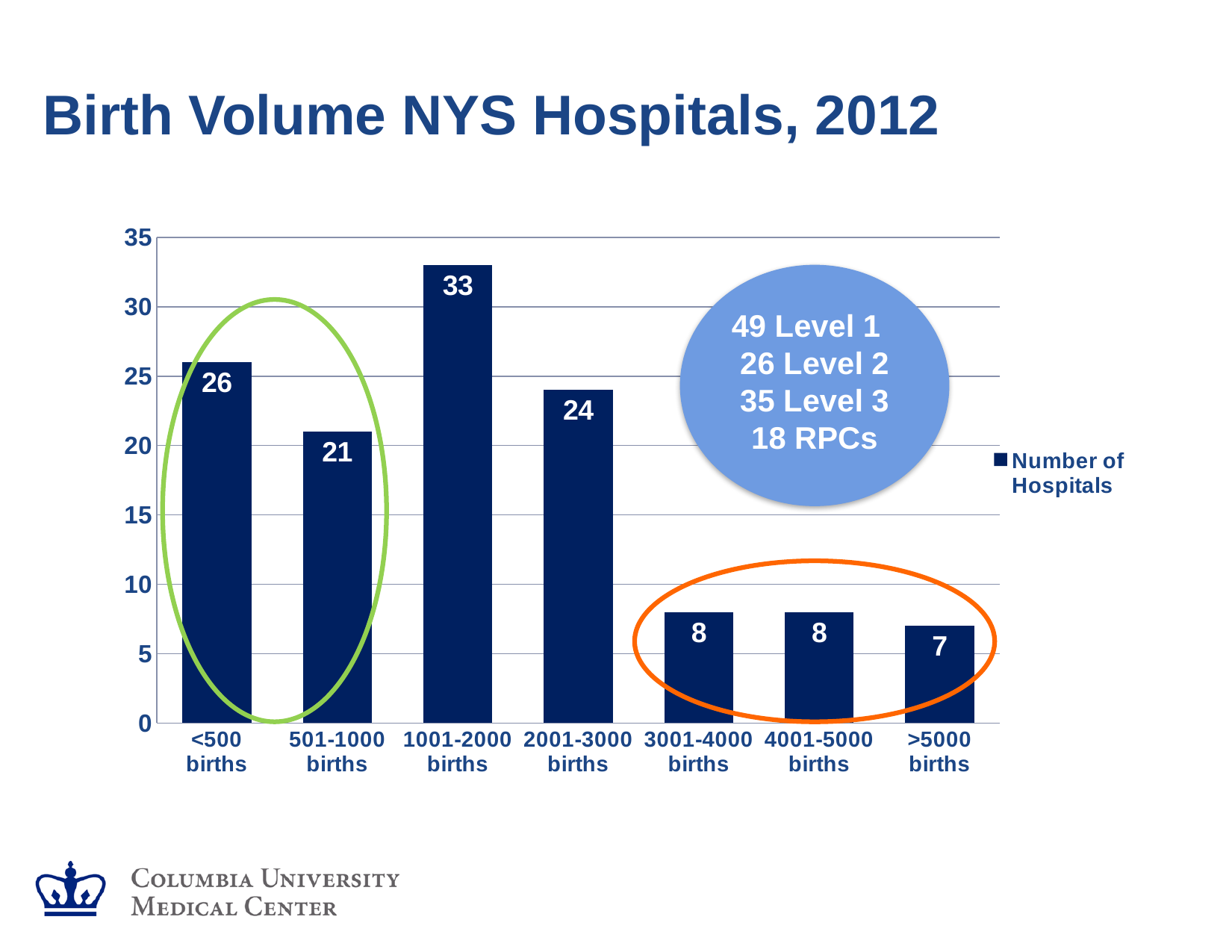
What kind of chart is shown on the slide? Bar chart What is the title of the chart on the slide? Birth Volume NYS Hospitals, 2012 Which birth volume category has the highest number of hospitals? 1001-2000 births What is the value for the >5000 births category? 7 What is the difference in number of hospitals between the 1001-2000 births and 2001-3000 births categories? 9 Which has more hospitals: the <500 births category or the 501-1000 births category? <500 births How many birth volume categories are shown on the x axis? 7 What is the number of hospitals for the <500 births category? 26 How many hospitals are in the 1001-2000 births category? 33 How many series does the legend list? 1 Is the value for the 2001-3000 births category greater or less than 20? greater Which birth volume category has the lowest number of hospitals? >5000 births